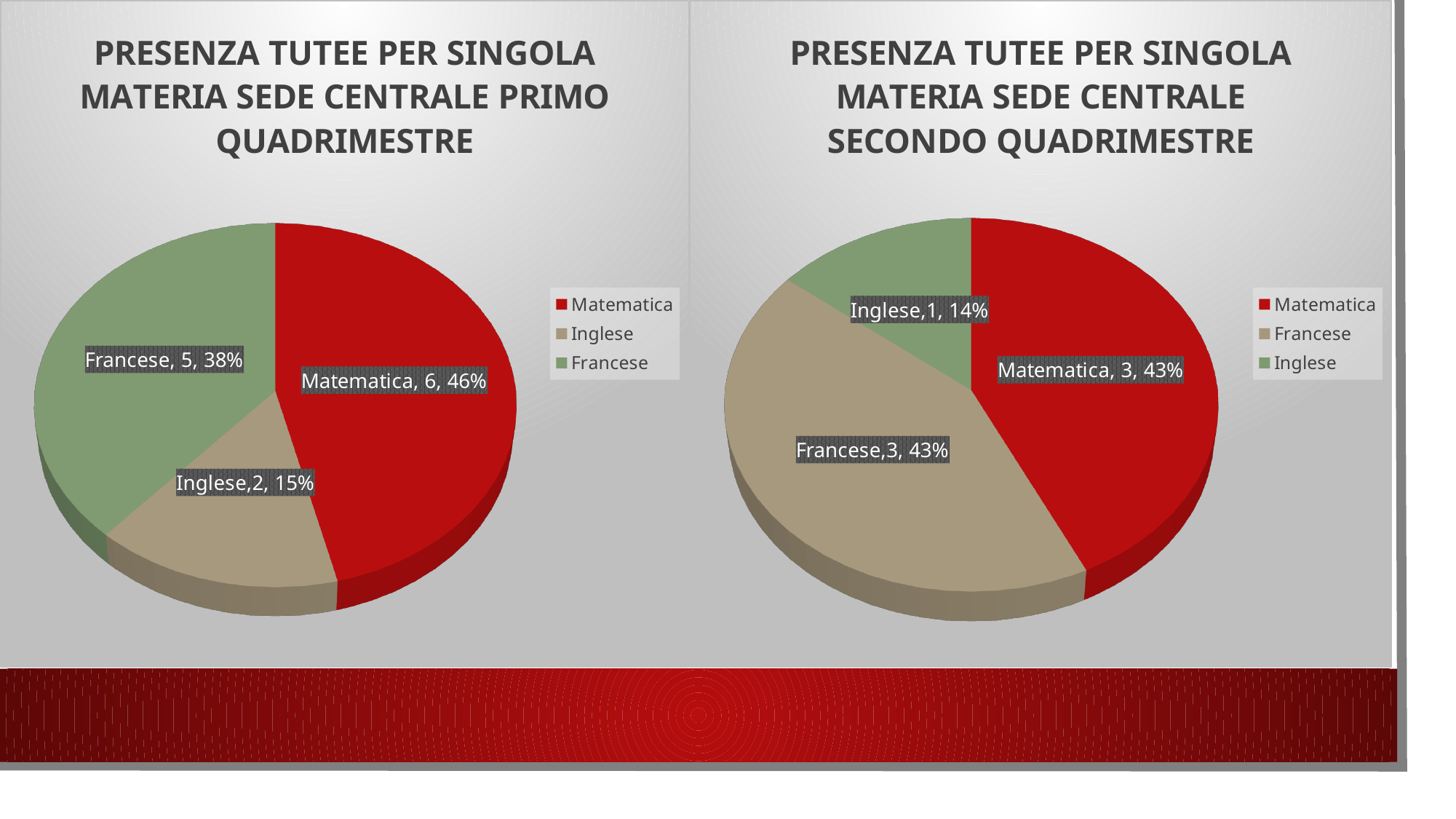
In the left chart (Primo Quadrimestre), what is the value for Matematica? 6 In the left chart (Primo Quadrimestre), what share of the pie does Francese have? 38% In the right chart (Secondo Quadrimestre), which subject has the smallest slice? Inglese In the right chart (Secondo Quadrimestre), what share of the pie does Francese have? 43% In the right chart (Secondo Quadrimestre), what is the value for Inglese? 1 In the left chart (Primo Quadrimestre), what is the difference between the values for Matematica and Inglese? 4 In the left chart (Primo Quadrimestre), which colour represents Francese? Green How many categories does the right chart (Secondo Quadrimestre) show? 3 In the left chart (Primo Quadrimestre), which subject has the smallest slice? Inglese In the left chart (Primo Quadrimestre), which subject has the largest slice? Matematica What kind of chart is used on the left of the slide? Pie chart In the right chart (Secondo Quadrimestre), what is the total of all the slice values? 7